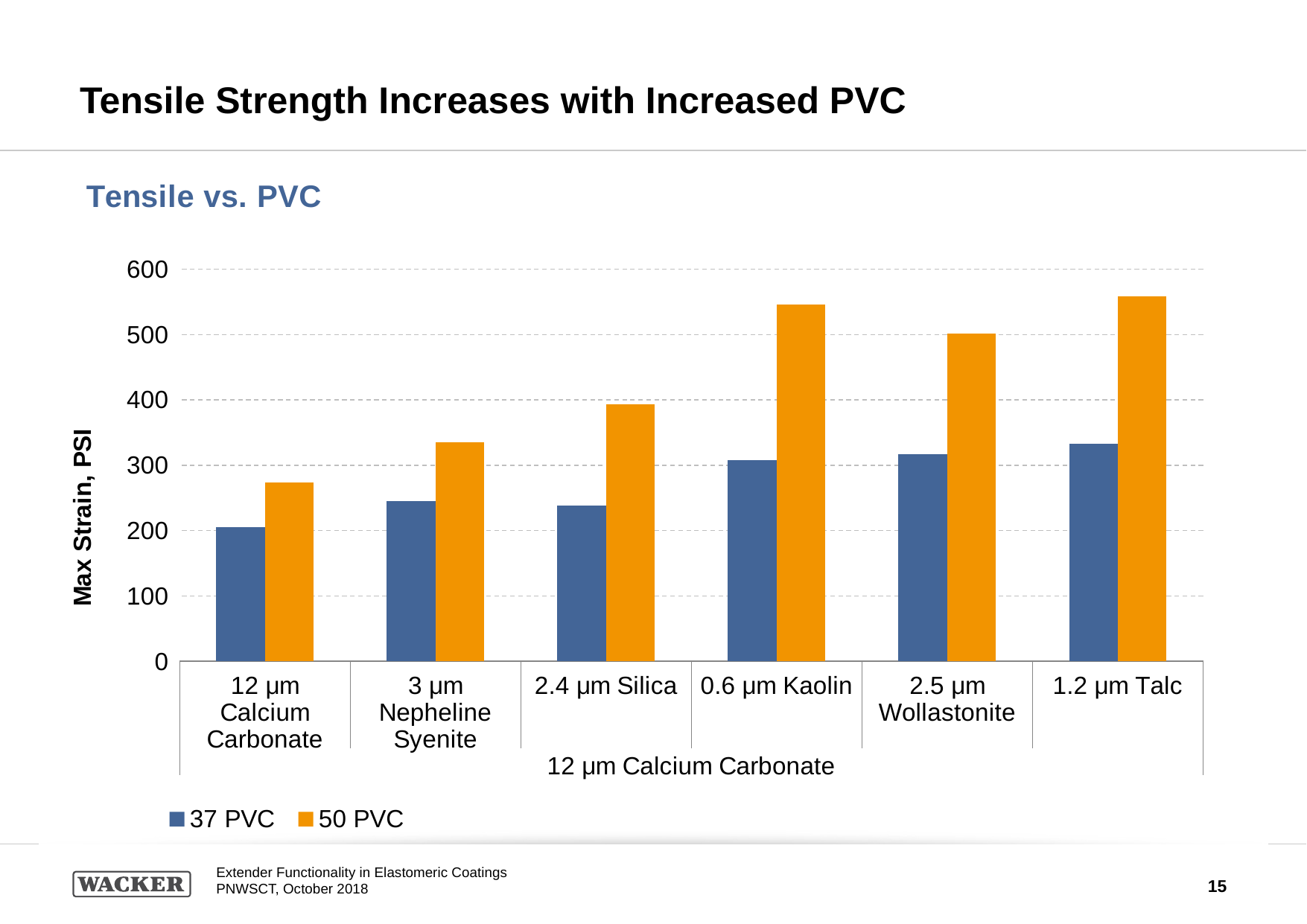
What kind of chart is shown on the slide? bar chart Is the 37 PVC value for 3 µm Nepheline Syenite greater or less than 300? less Which is larger, the 50 PVC value for 0.6 µm Kaolin or the 50 PVC value for 2.4 µm Silica? 0.6 µm Kaolin Is the 37 PVC value for 1.2 µm Talc greater or less than 300? greater Which extender has the lowest 37 PVC value? 12 µm Calcium Carbonate How many extender categories are shown on the x axis? 6 What is the label of the y axis? Max Strain, PSI Is the 50 PVC value for 2.5 µm Wollastonite greater or less than 400? greater Which extender has the lowest 50 PVC value? 12 µm Calcium Carbonate For 2.4 µm Silica, which series has the larger value, 37 PVC or 50 PVC? 50 PVC How many series does the legend list? 2